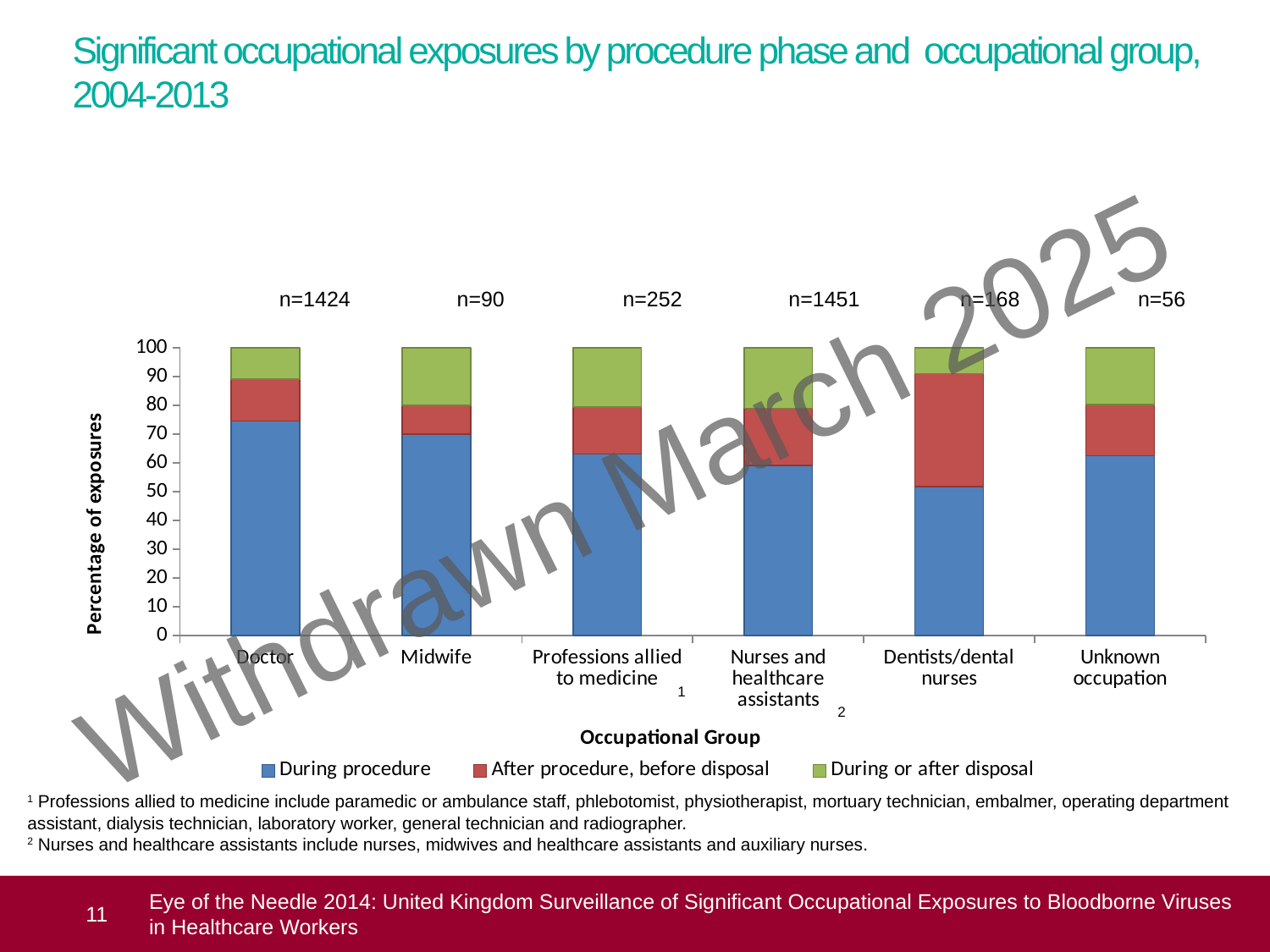
Is the 'During procedure' value for Dentists/dental nurses greater or less than 60? less Which occupational group has the smallest 'During procedure' segment? Dentists/dental nurses What is the title of the y axis? Percentage of exposures What is the difference between the n values for Nurses and healthcare assistants and Doctor? 27 What kind of chart is shown on the slide? Stacked bar chart Which occupational group has the smallest n value shown above its bar? Unknown occupation How many series does the legend list? 3 What is the n value shown above the Dentists/dental nurses bar? n=168 Which occupational group has the largest n value shown above its bar? Nurses and healthcare assistants What is the n value shown above the Doctor bar? n=1424 Is the 'During procedure' value for Doctor greater or less than 70? greater How many occupational groups are shown on the x axis? 6